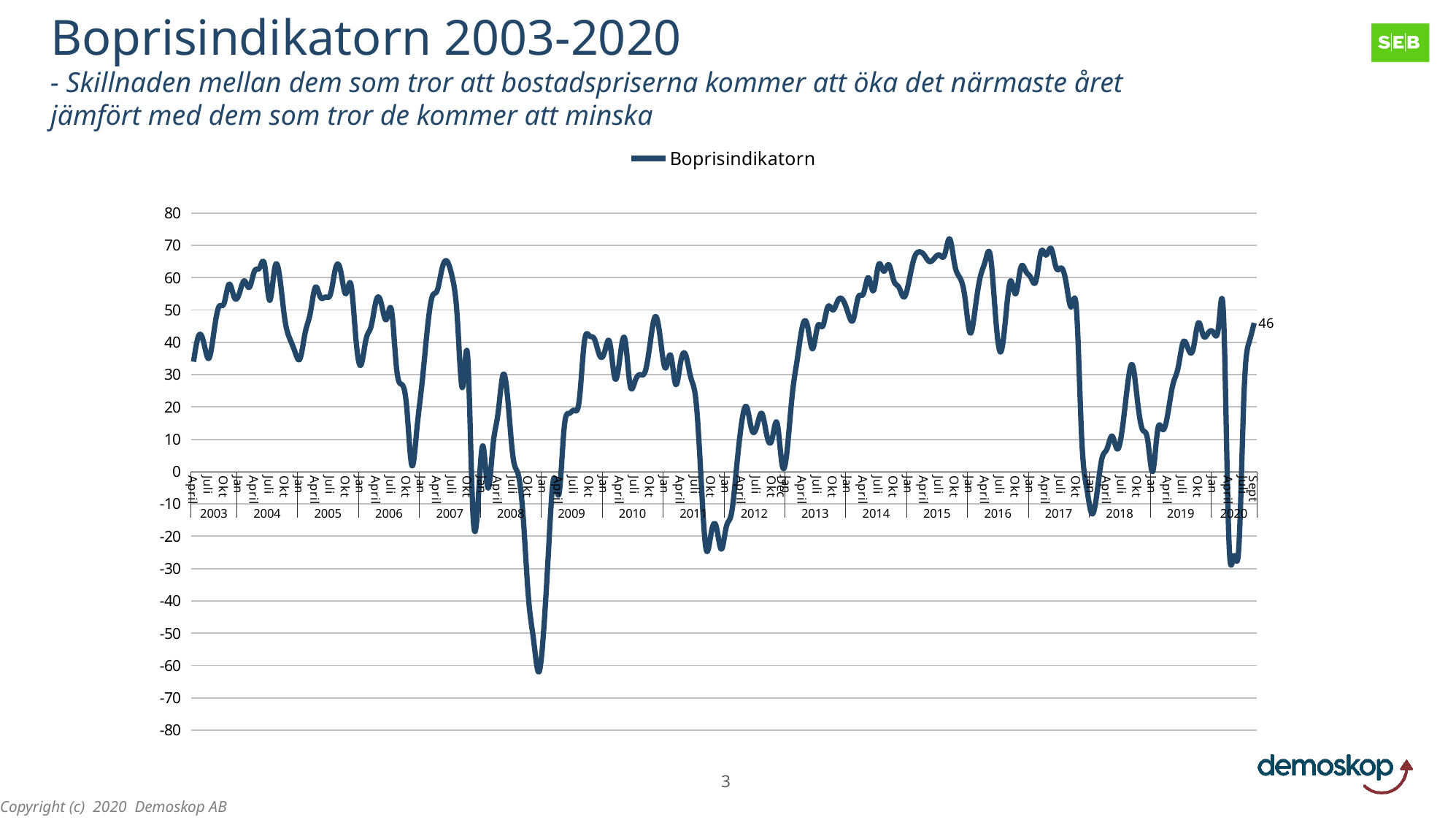
How many years are labelled along the x axis? 18 Is the highest value of Boprisindikatorn in 2015 greater or less than 60? greater What kind of chart is shown on the slide? line chart What is the value of Boprisindikatorn at the last point (Sept 2020), as printed on the chart? 46 What is the name of the series shown in the legend? Boprisindikatorn Is the lowest value of Boprisindikatorn in 2020 greater or less than -20? less How many series does the legend list? 1 Between the 2020 low point and Sept 2020, does Boprisindikatorn rise or fall? rise In which year does Boprisindikatorn reach its highest value? 2015 In which year does Boprisindikatorn reach its lowest value? 2008 Is the value of Boprisindikatorn at the first point (April 2003) greater or less than 30? greater